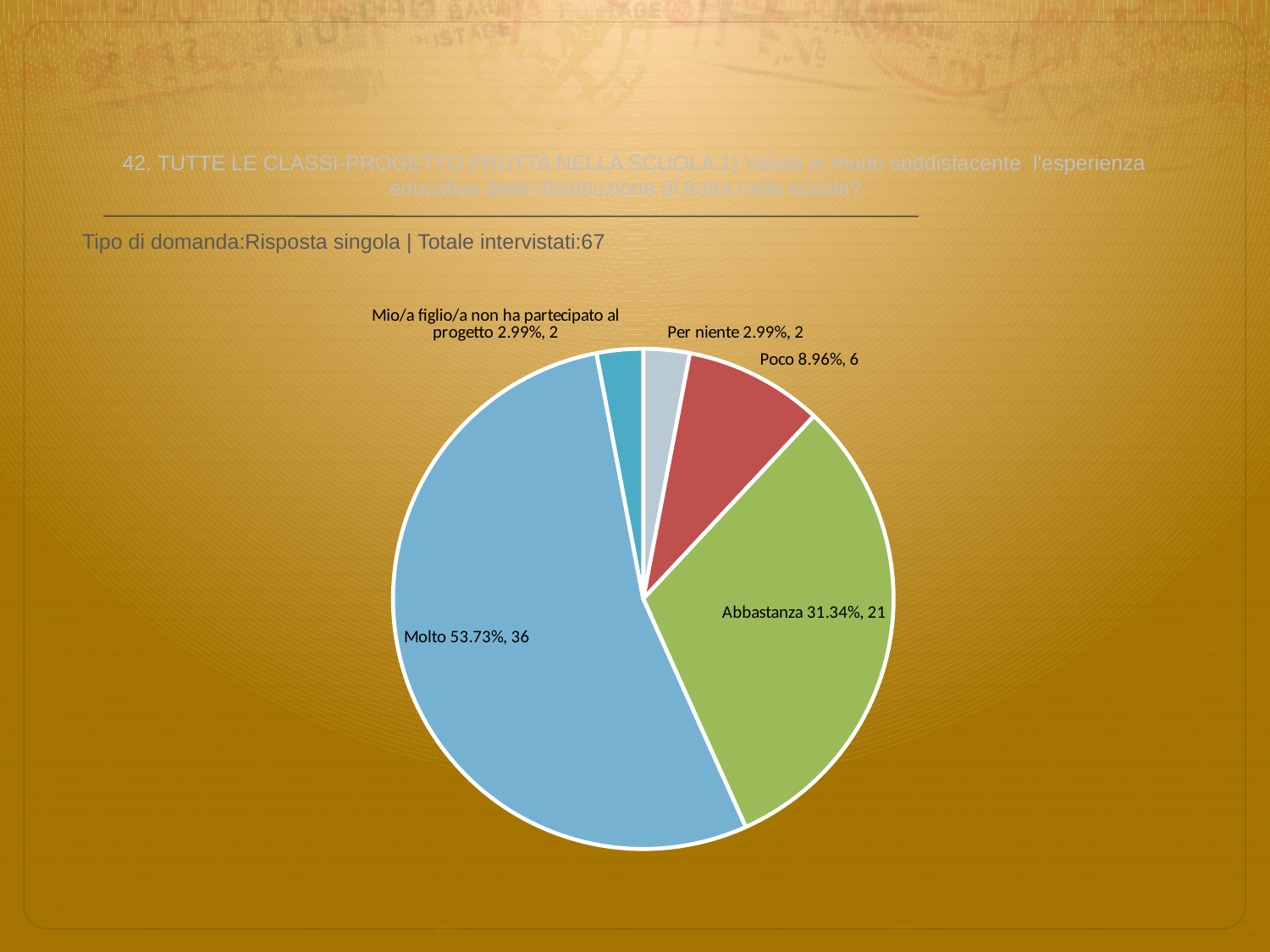
What kind of chart is shown on the slide? pie chart How many respondents answered 'Abbastanza'? 21 What colour is the 'Abbastanza' slice? green What is the difference in count between 'Molto' and 'Abbastanza'? 15 What is the total number of respondents stated on the slide? 67 How many respondents answered 'Per niente'? 2 Which category has the largest slice of the pie? Molto What percentage share does the 'Molto' slice have? 53.73% What percentage share does the 'Poco' slice have? 8.96% What percentage share does the 'Mio/a figlio/a non ha partecipato al progetto' slice have? 2.99% Which is larger, the 'Poco' slice or the 'Per niente' slice? Poco How many slices does the pie chart have? 5